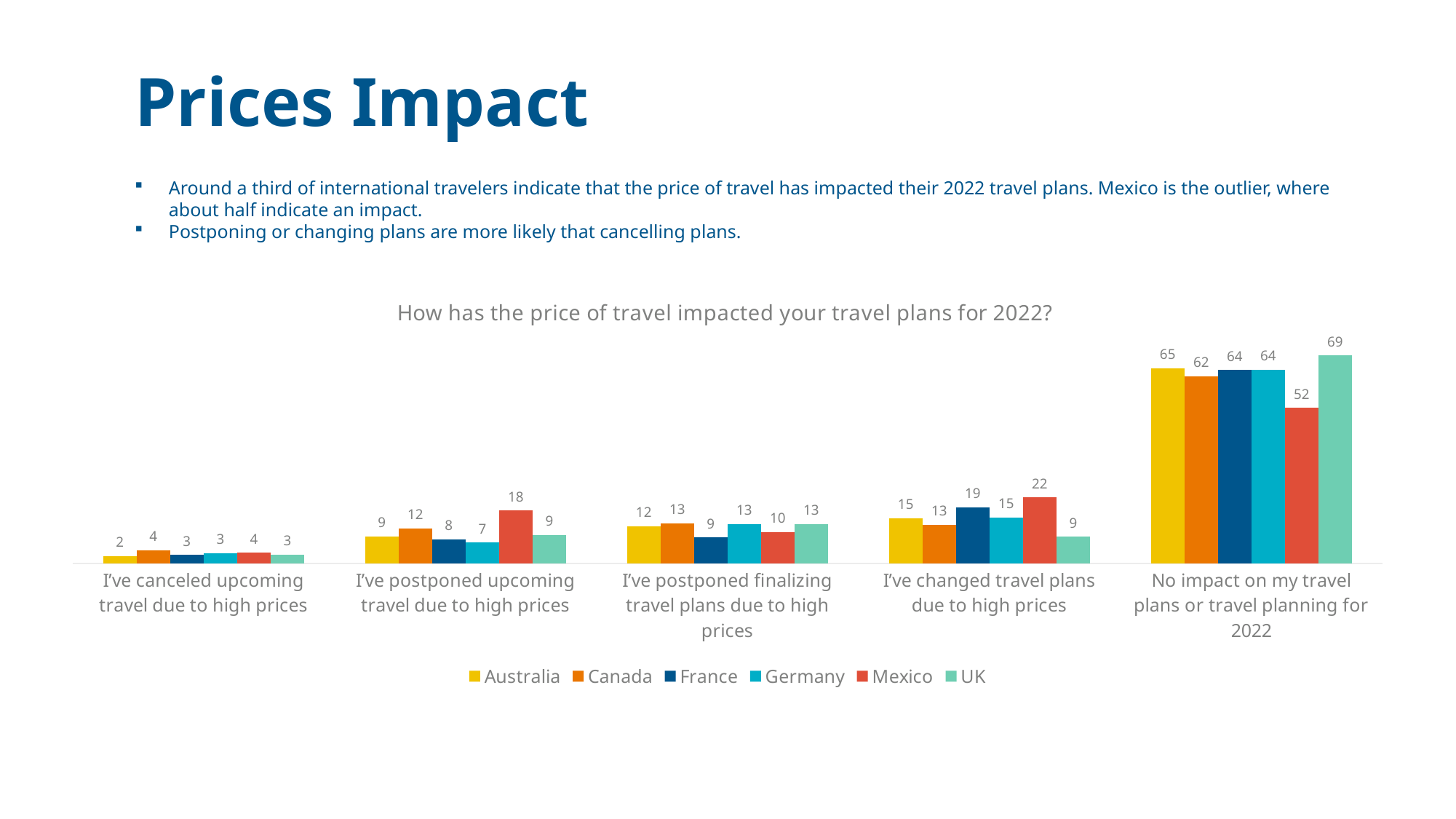
Which country has the highest value in the 'I've changed travel plans due to high prices' category? Mexico How many series does the legend list? 6 Which country is represented by the red bars in the chart? Mexico What is the difference between the UK and Mexico values in the 'No impact on my travel plans or travel planning for 2022' category? 17 How many response categories are shown on the x axis? 5 What is the value for Mexico in the 'I've postponed upcoming travel due to high prices' category? 18 What is the value for the UK in the 'No impact on my travel plans or travel planning for 2022' category? 69 What kind of chart is shown on the slide? Bar chart What is the title of the chart? How has the price of travel impacted your travel plans for 2022? Which country has the lowest value in the 'No impact on my travel plans or travel planning for 2022' category? Mexico What is the value for France in the 'I've changed travel plans due to high prices' category? 19 In the 'I've postponed upcoming travel due to high prices' category, which is larger: the value for Canada or the value for Germany? Canada